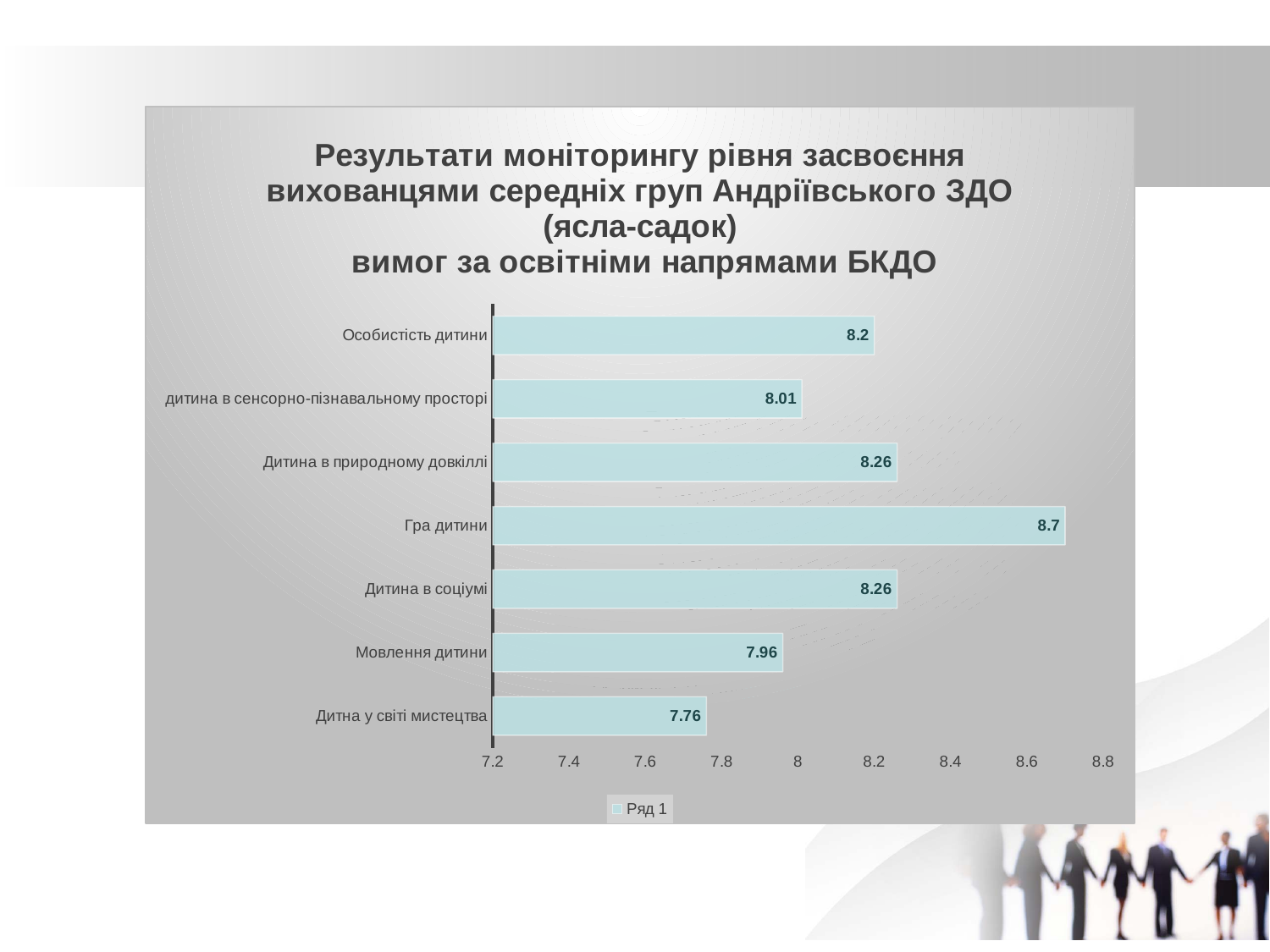
What is the value for Гра дитини? 8.7 Which category has the highest value? Гра дитини What is the value for дитина в сенсорно-пізнавальному просторі? 8.01 What is the value for Мовлення дитини? 7.96 How many series does the legend list? 1 What is the difference between the values for Гра дитини and Дитна у світі мистецтва? 0.94 Is the value for Мовлення дитини greater or less than 8? less What kind of chart is shown on the slide? bar chart How many categories are shown in the chart? 7 Which category has the lowest value? Дитна у світі мистецтва What is the difference between the values for Особистість дитини and Мовлення дитини? 0.24 Which is larger, the value for Дитина в соціумі or the value for Особистість дитини? Дитина в соціумі